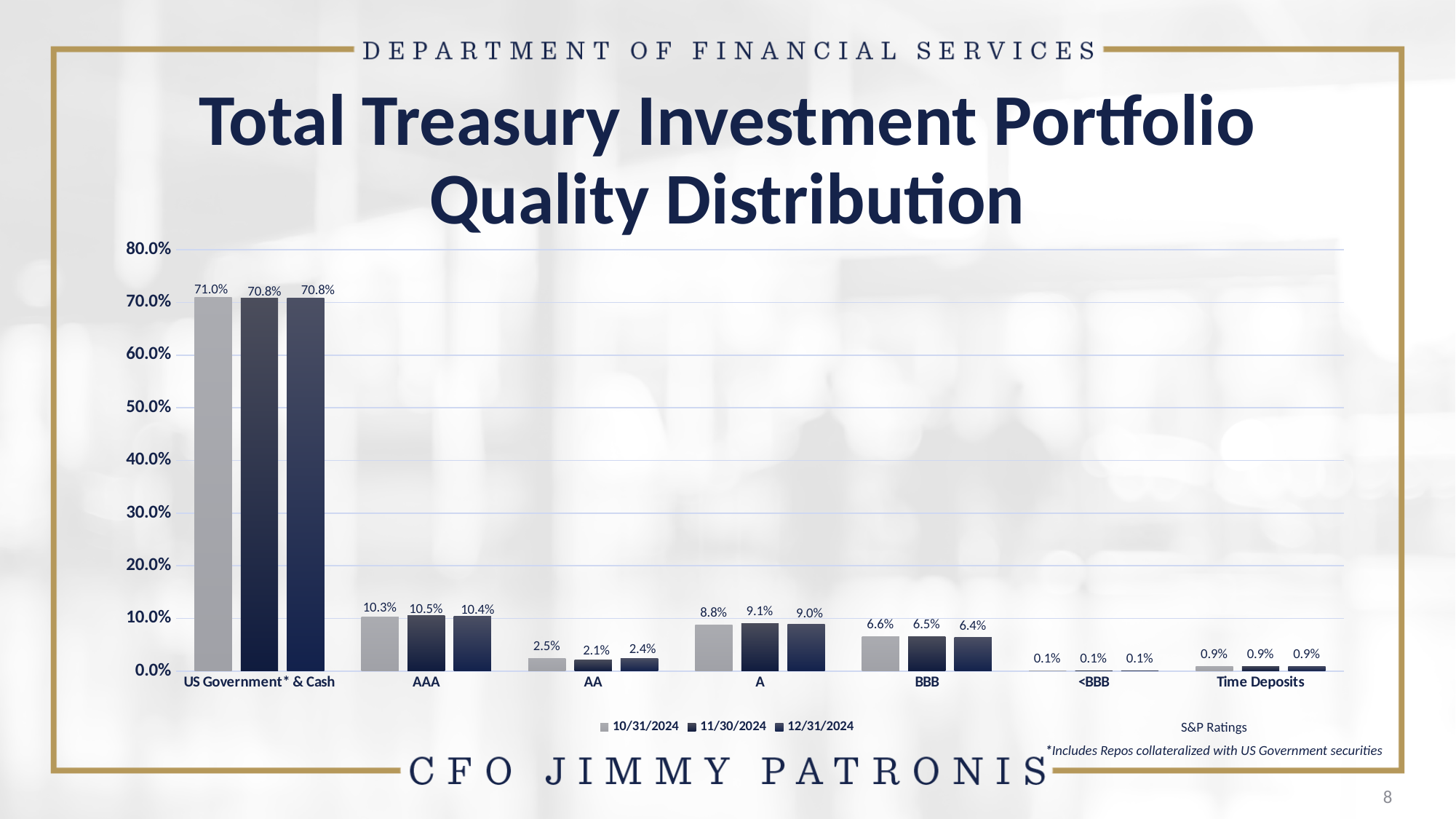
What is the value for AAA in the 11/30/2024 series? 10.5% Which category has the lowest value in the 10/31/2024 series? <BBB What is the value for BBB in the 12/31/2024 series? 6.4% What is the value for AA in the 12/31/2024 series? 2.4% Which category has the highest value in the 12/31/2024 series? US Government* & Cash What is the difference between the 10/31/2024 and 12/31/2024 values for US Government* & Cash? 0.2% How many rating categories are shown on the x axis? 7 How many series does the legend list? 3 Which is larger for the A category: the 10/31/2024 value or the 11/30/2024 value? 11/30/2024 What is the title of the chart? Total Treasury Investment Portfolio Quality Distribution What is the value for US Government* & Cash in the 10/31/2024 series? 71.0% What kind of chart is shown on the slide? Bar chart